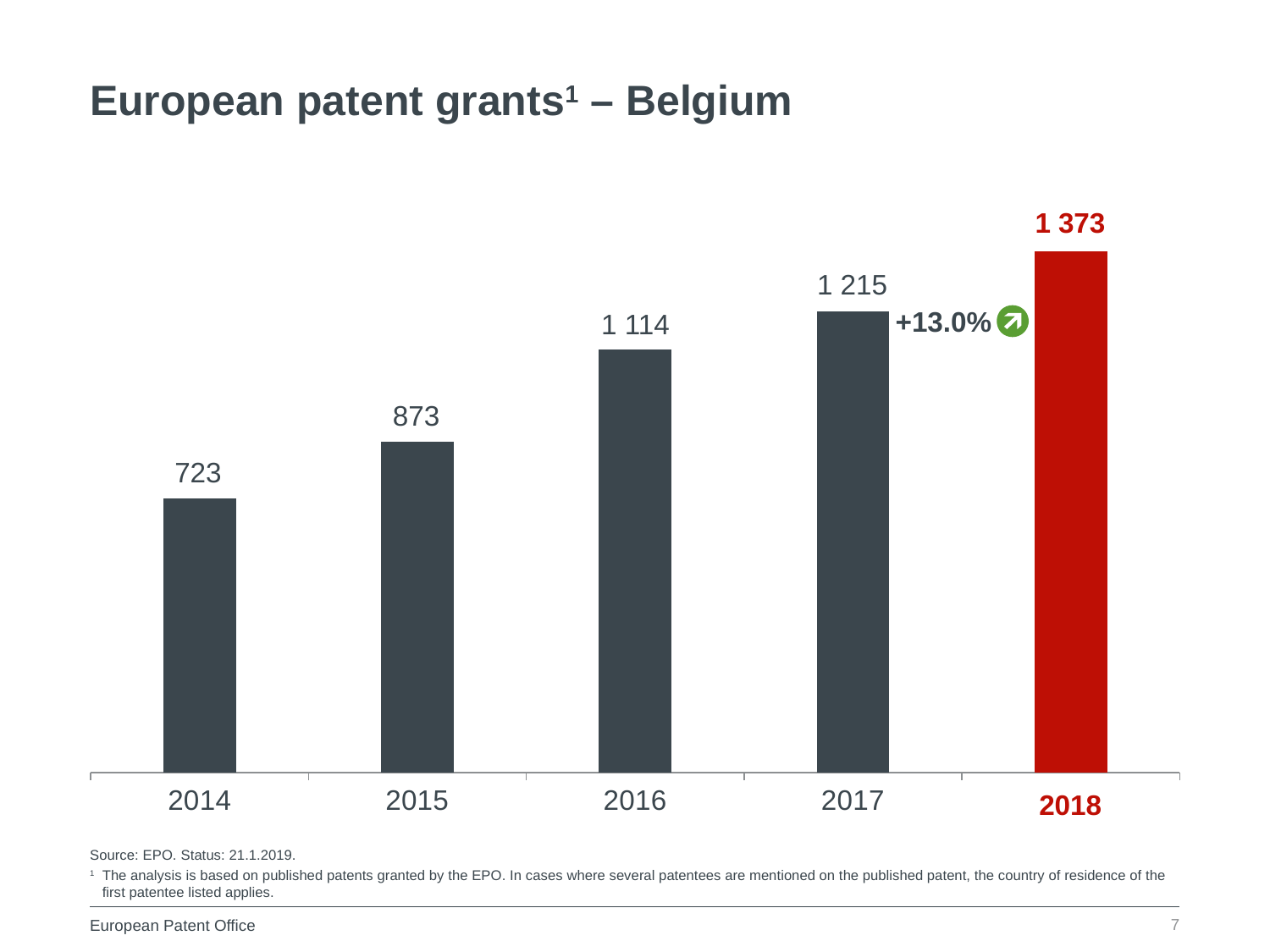
Do the values rise or fall from 2014 to 2018? rise What is the difference between the values for 2015 and 2014? 150 How many years are shown on the chart? 5 Which year has the highest value? 2018 What percentage change is shown between 2017 and 2018? +13.0% What is the value for 2016? 1 114 Which year has the lowest value? 2014 What is the difference between the values for 2018 and 2017? 158 Which is larger, the value for 2016 or the value for 2015? 2016 What is the value for 2018? 1 373 What is the value for 2014? 723 What kind of chart is shown on the slide? bar chart